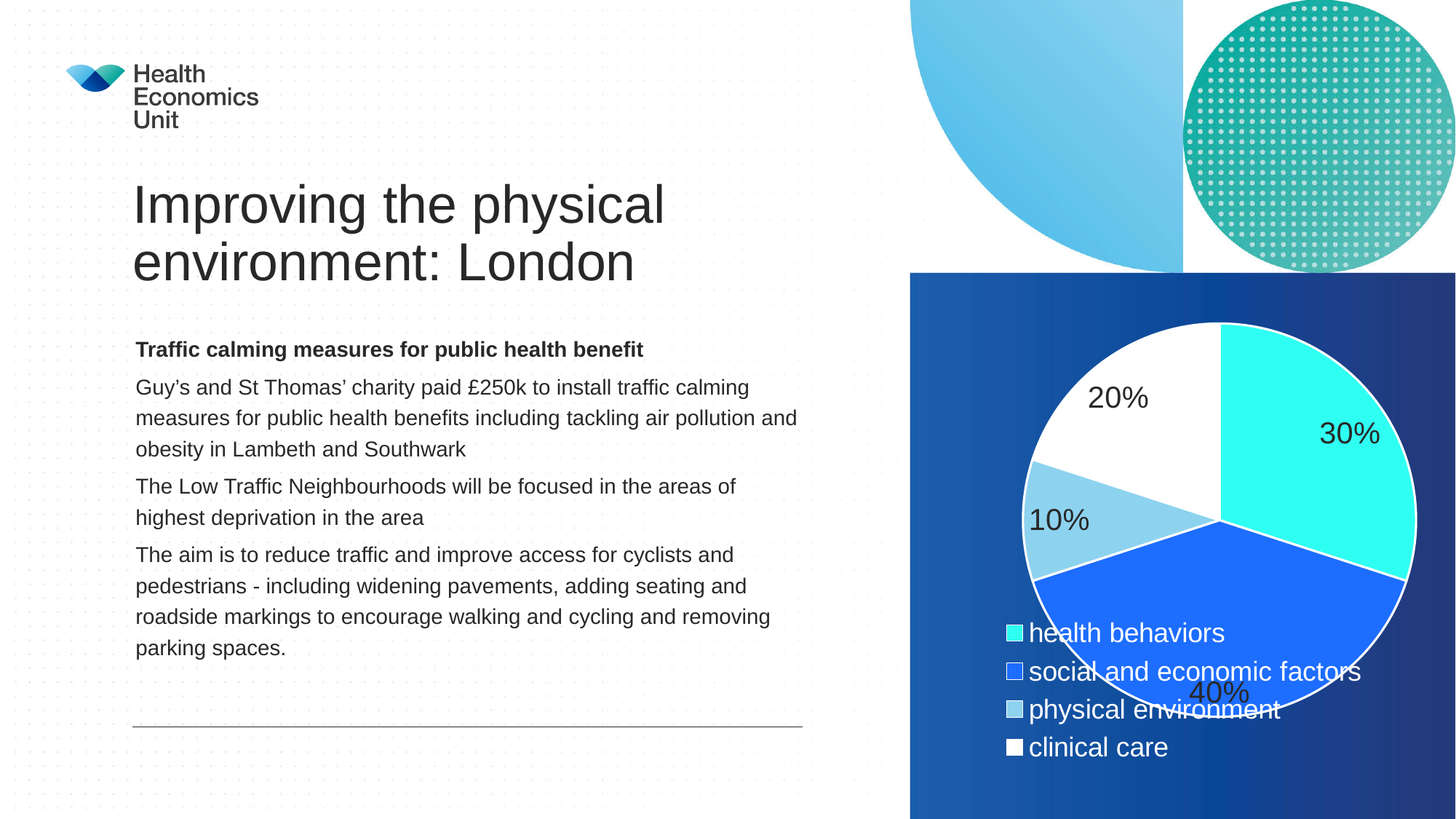
Which category is shown in white in the pie chart? clinical care Which is larger, the share for health behaviors or the share for clinical care? health behaviors How many entries does the legend list? 4 What share of the pie does physical environment have? 10% How many slices does the pie chart have? 4 Which category has the largest slice of the pie? social and economic factors Which category has the smallest slice of the pie? physical environment What is the difference between the shares for social and economic factors and clinical care? 20% What share of the pie does social and economic factors have? 40% What share of the pie does health behaviors have? 30% What share of the pie does clinical care have? 20% What kind of chart is shown on the slide? pie chart